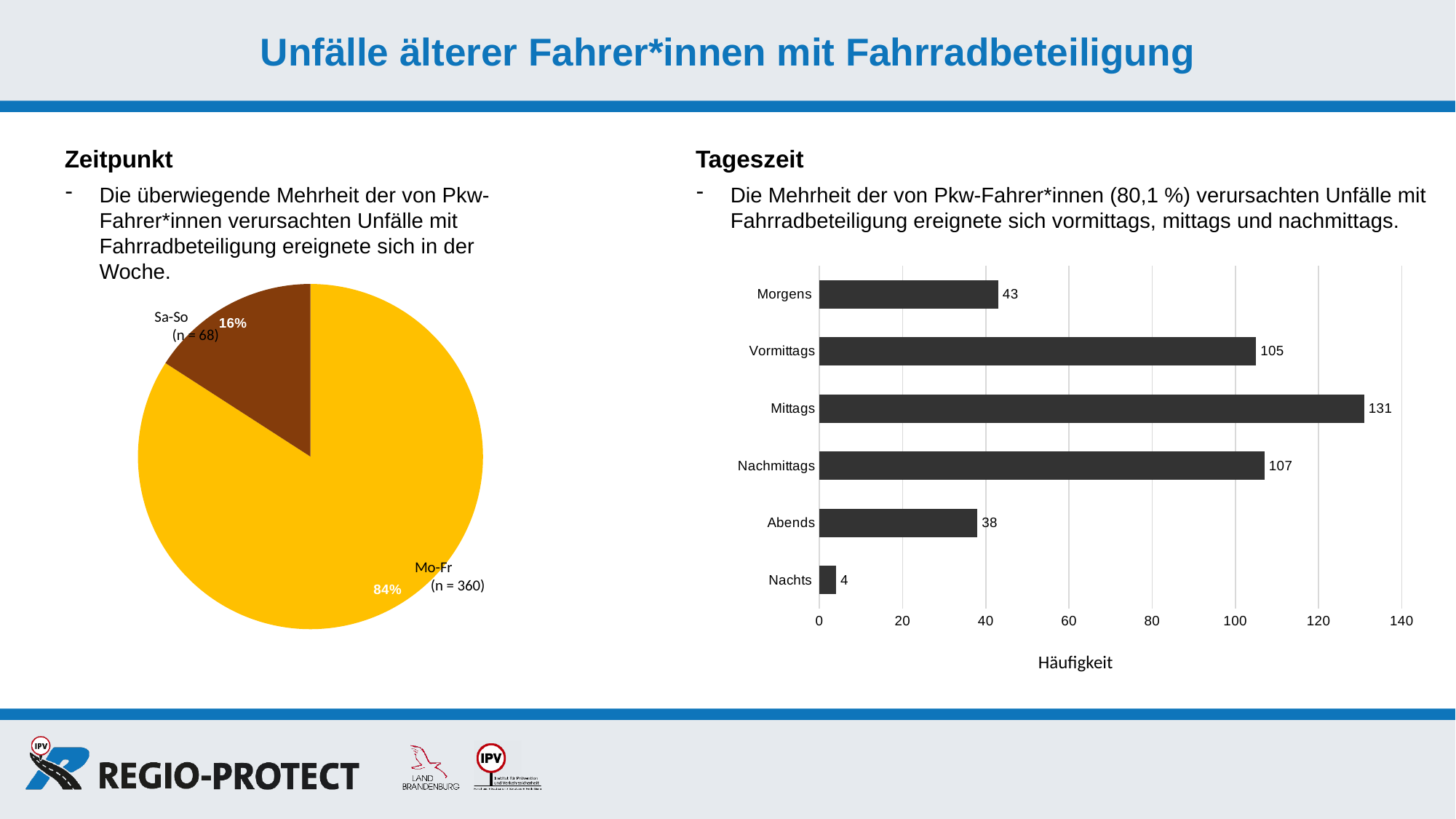
In the pie chart on the left (Zeitpunkt), what is the n value for Sa-So? n = 68 In the pie chart on the left (Zeitpunkt), how many slices are there? 2 In the bar chart on the right (Tageszeit), what is the value for Nachts? 4 In the pie chart on the left (Zeitpunkt), what share does Mo-Fr have? 84% In the bar chart on the right (Tageszeit), which category has the highest value? Mittags In the bar chart on the right (Tageszeit), which is larger, the value for Vormittags or the value for Nachmittags? Nachmittags In the bar chart on the right (Tageszeit), what is the difference between the values for Mittags and Morgens? 88 In the bar chart on the right (Tageszeit), which category has the lowest value? Nachts What is the x-axis label of the bar chart on the right (Tageszeit)? Häufigkeit In the bar chart on the right (Tageszeit), how many categories are shown? 6 What kind of chart is the chart on the right (Tageszeit)? Bar chart In the bar chart on the right (Tageszeit), what is the value for Mittags? 131